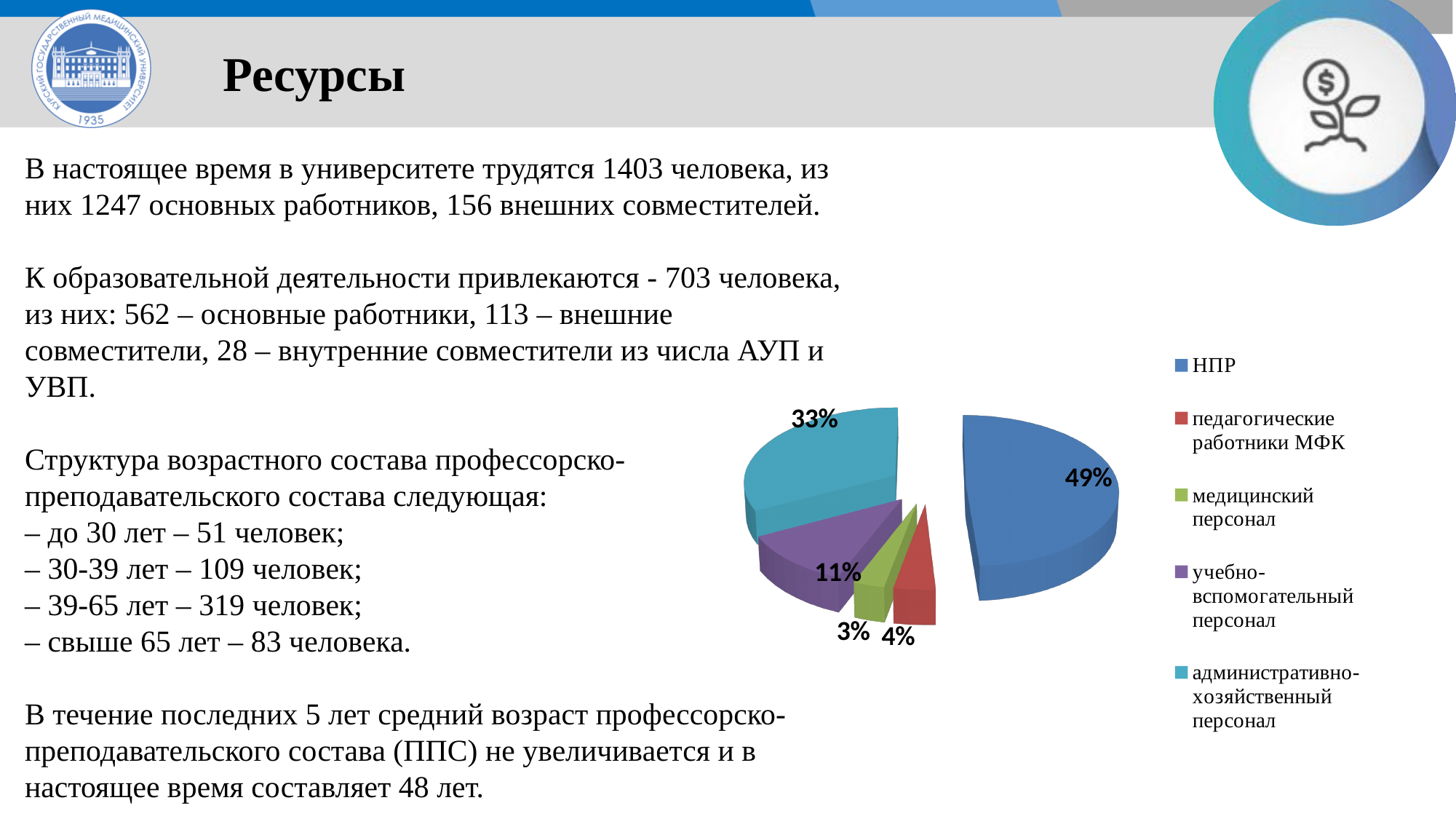
What share of the pie does НПР have? 49% What kind of chart is shown on the slide? pie chart What share of the pie does медицинский персонал have? 3% What share of the pie does учебно-вспомогательный персонал have? 11% What colour is the slice for НПР in the pie chart? blue What is the difference in percentage points between НПР and административно-хозяйственный персонал? 16% How many categories does the pie chart show? 5 Which category has the smallest slice of the pie? медицинский персонал Which category has the largest slice of the pie? НПР Which is larger, the share for учебно-вспомогательный персонал or the share for педагогические работники МФК? учебно-вспомогательный персонал